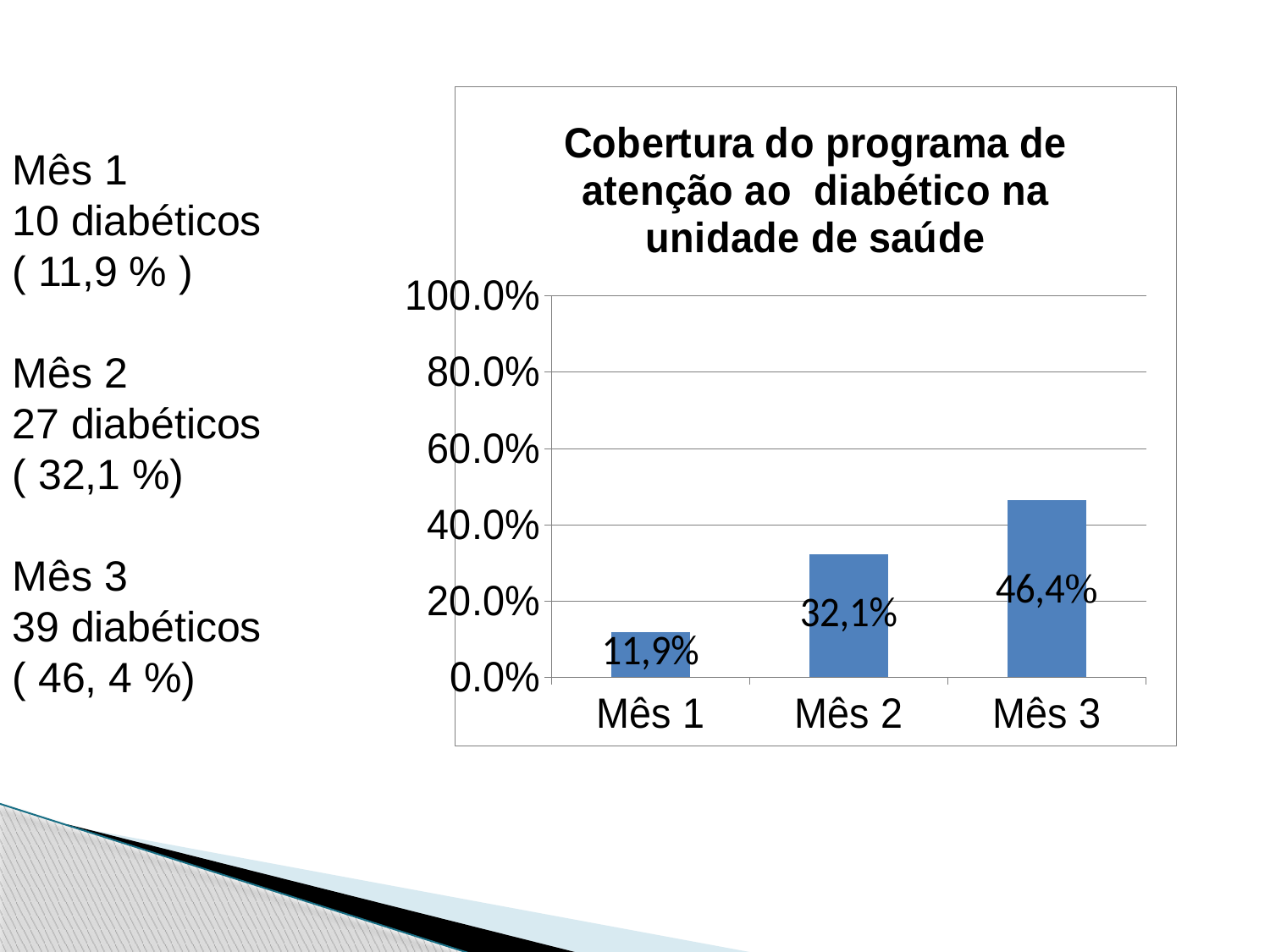
What is the difference between the values for Mês 2 and Mês 1? 20,2% Is the value for Mês 3 greater or less than 40.0%? greater What kind of chart is shown on the slide? Bar chart What is the value for Mês 2? 32,1% What is the difference between the values for Mês 3 and Mês 2? 14,3% Do the values rise or fall from Mês 1 to Mês 3? Rise Which month has the highest coverage value? Mês 3 Which month has the lowest coverage value? Mês 1 How many categories are shown on the x axis? 3 What is the value for Mês 3? 46,4% What is the value for Mês 1? 11,9% Which is larger, the value for Mês 1 or the value for Mês 2? Mês 2